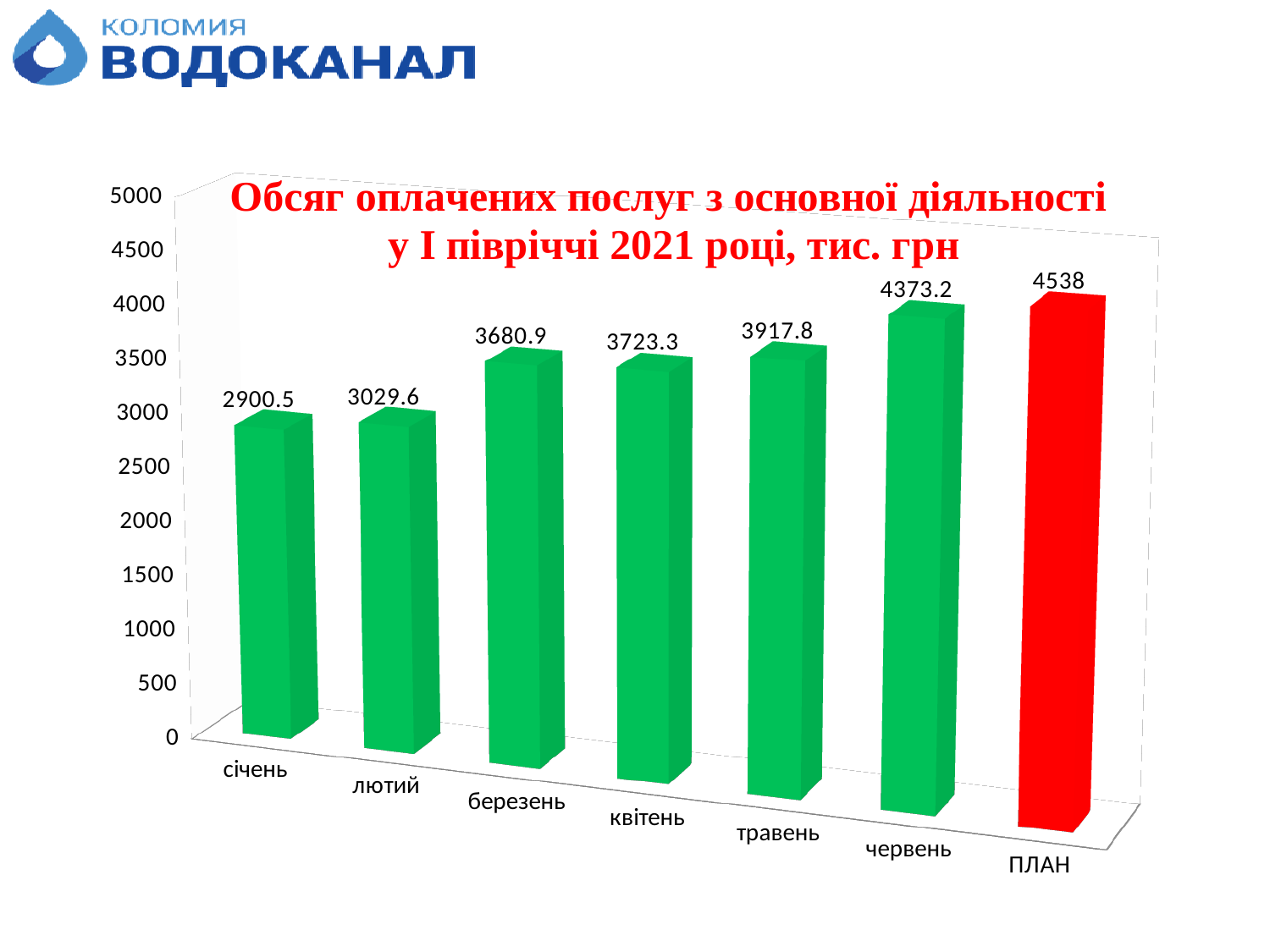
What is the value for ПЛАН? 4538 What is the value for січень? 2900.5 What is the difference between червень and січень? 1472.7 Do the monthly values rise or fall from січень to червень? rise Is the value for квітень greater or less than 3500? greater Which category has the highest value? ПЛАН How many categories are shown on the x axis? 7 What is the difference between ПЛАН and червень? 164.8 Which category has the lowest value? січень What is the value for червень? 4373.2 What kind of chart is this? bar chart Which is larger, the value for березень or the value for травень? травень